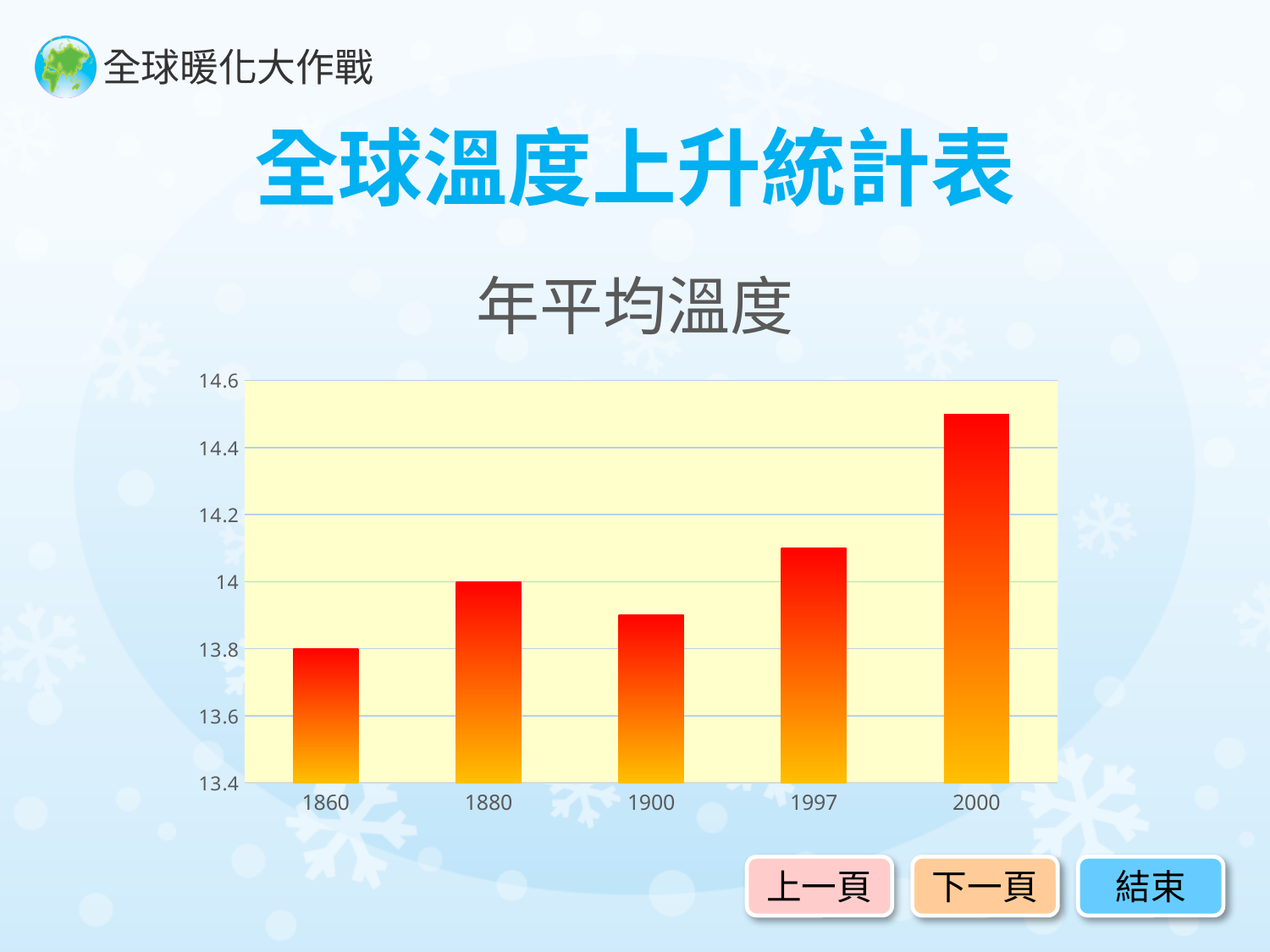
Which is larger, the value for 1900 or the value for 1997? 1997 Which year has the highest value? 2000 Is the value for 2000 greater or less than 14.4? greater Is the value for 1997 greater or less than 14.2? less How many years are shown on the x axis? 5 Is the value for 1900 greater or less than 14? less What kind of chart is shown? bar chart What is the value for 1860? 13.8 Which year has the lowest value? 1860 What is the title of the chart? 年平均溫度 What is the difference between the values for 1880 and 1860? 0.2 What is the value for 1880? 14